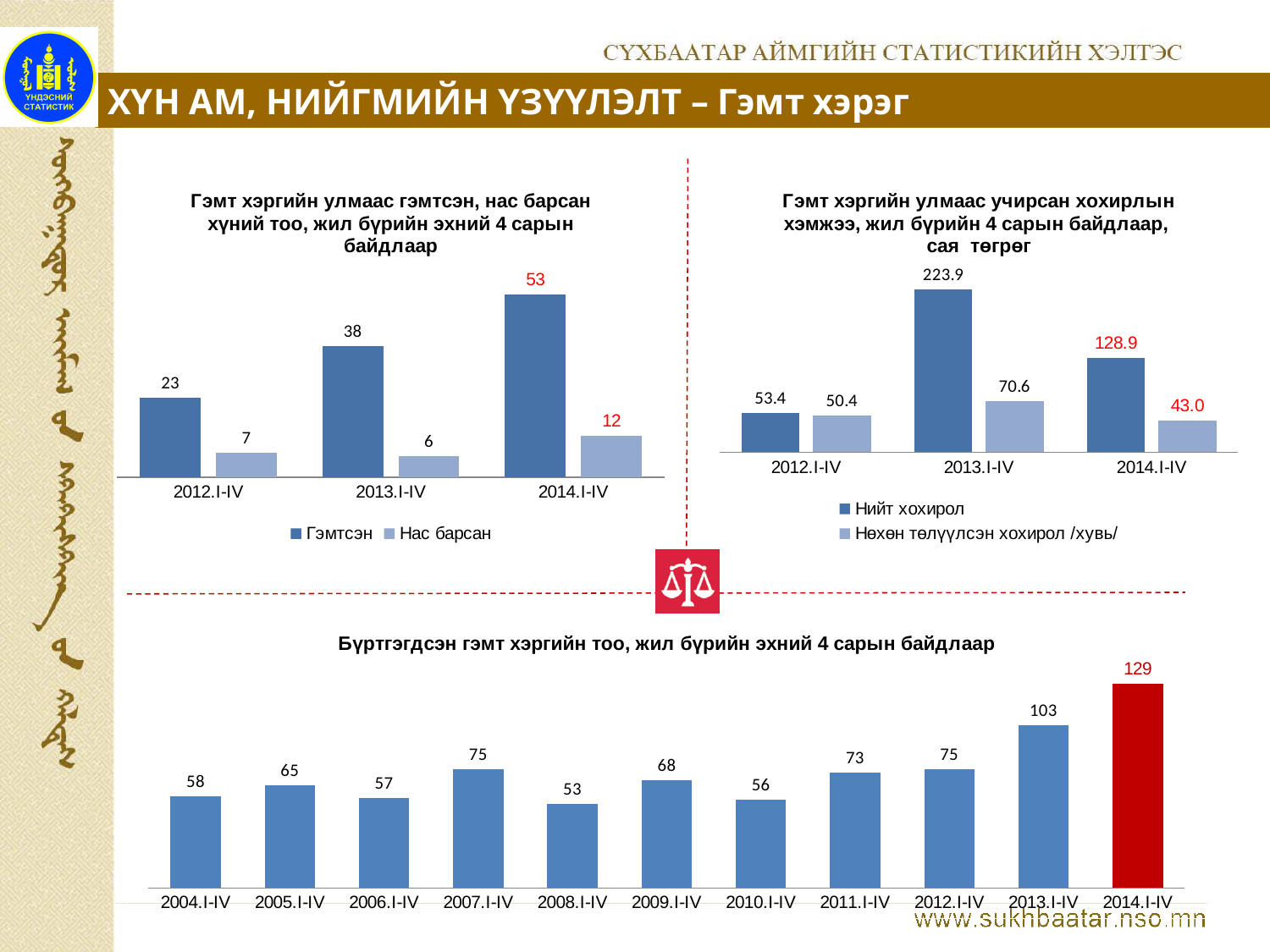
How many series does the legend of the top-left chart (Гэмт хэргийн улмаас гэмтсэн, нас барсан хүний тоо) list? 2 What kind of chart is the bottom chart (Бүртгэгдсэн гэмт хэргийн тоо)? Bar chart In the top-right chart (Гэмт хэргийн улмаас учирсан хохирлын хэмжээ), which period has the highest Нийт хохирол? 2013.I-IV In the top-right chart (Гэмт хэргийн улмаас учирсан хохирлын хэмжээ), what is the value for Нөхөн төлүүлсэн хохирол /хувь/ in 2014.I-IV? 43.0 In the top-right chart (Гэмт хэргийн улмаас учирсан хохирлын хэмжээ), which is larger in 2012.I-IV: Нийт хохирол or Нөхөн төлүүлсэн хохирол /хувь/? Нийт хохирол In the bottom chart (Бүртгэгдсэн гэмт хэргийн тоо), what is the value for 2013.I-IV? 103 In the top-left chart (Гэмт хэргийн улмаас гэмтсэн, нас барсан хүний тоо), what is the difference between Гэмтсэн and Нас барсан in 2012.I-IV? 16 In the top-left chart (Гэмт хэргийн улмаас гэмтсэн, нас барсан хүний тоо), what is the value for Нас барсан in 2013.I-IV? 6 In the bottom chart (Бүртгэгдсэн гэмт хэргийн тоо), which period has the lowest value? 2008.I-IV In the top-left chart (Гэмт хэргийн улмаас гэмтсэн, нас барсан хүний тоо), what is the value for Гэмтсэн in 2014.I-IV? 53 In the top-right chart (Гэмт хэргийн улмаас учирсан хохирлын хэмжээ), what is the value for Нийт хохирол in 2013.I-IV? 223.9 How many periods are shown on the x axis of the bottom chart (Бүртгэгдсэн гэмт хэргийн тоо)? 11